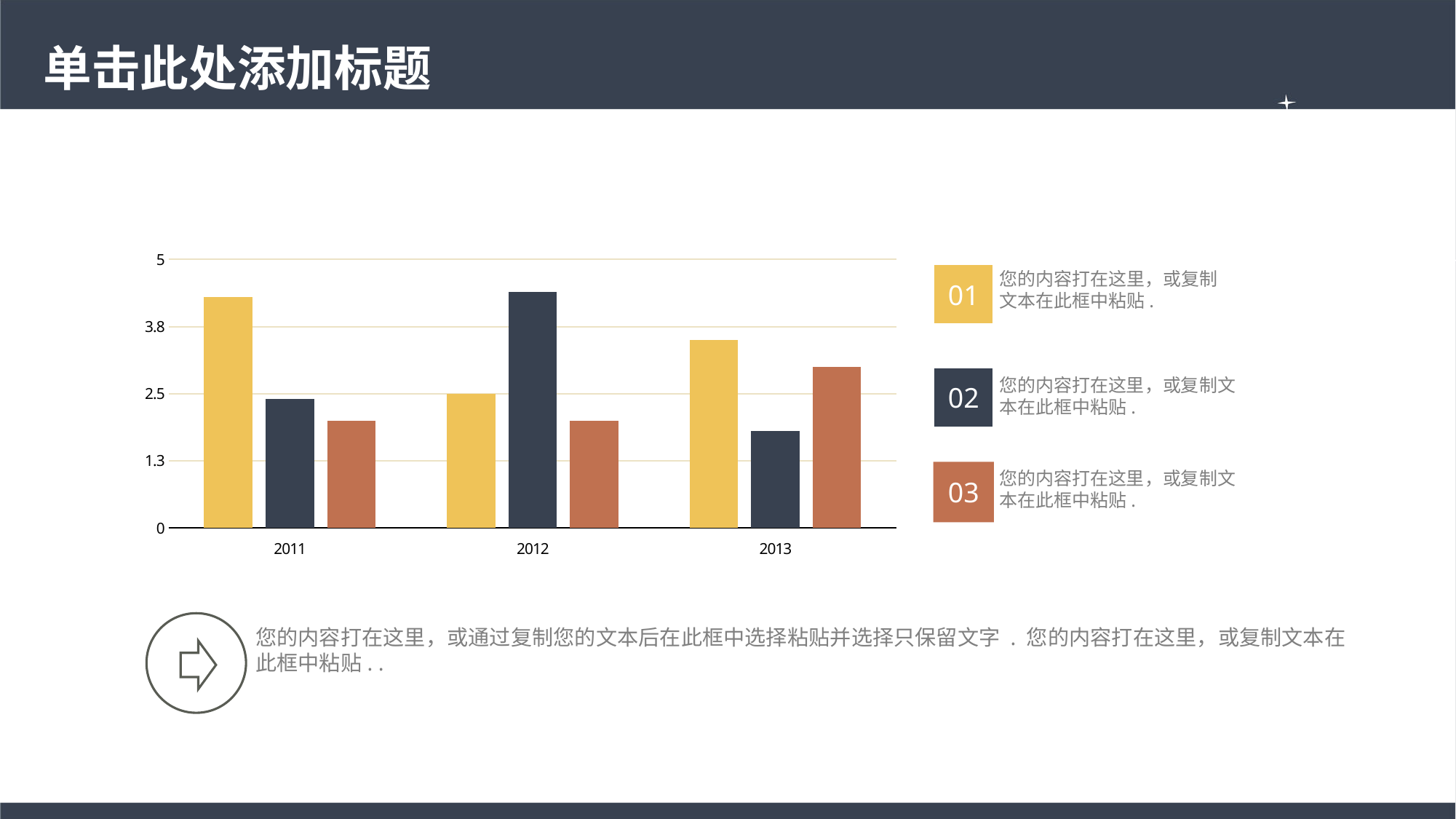
Which bar is the shortest in the 2013 group? the dark blue bar Which bar is the tallest in the 2012 group? the dark blue bar Which bar is the tallest in the 2011 group? the yellow bar Which is larger in 2013, the yellow bar or the orange bar? the yellow bar Is the value of the orange bar for 2013 greater or less than 2.5? greater Which years are shown on the x axis of the chart? 2011, 2012, 2013 Is the value of the dark blue bar for 2013 greater or less than 2.5? less Is the value of the yellow bar for 2011 greater or less than 3.8? greater What is the highest value shown on the y axis of the chart? 5 How many bars are shown for each year in the chart? 3 What kind of chart is shown on the slide? bar chart How many categories are shown on the x axis of the chart? 3